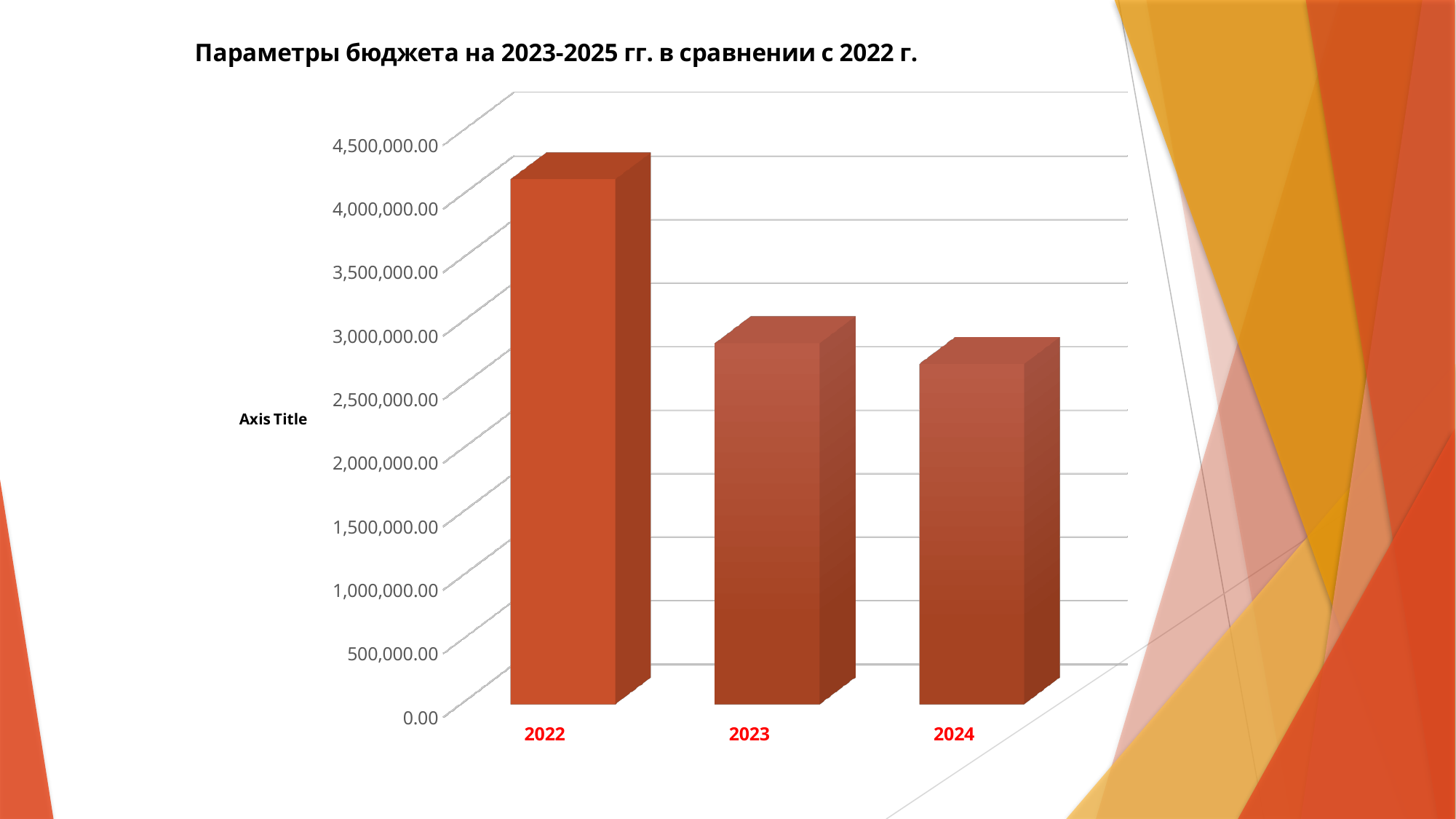
Is the value for 2023 greater or less than 3,500,000.00? less What text is shown as the vertical axis title? Axis Title What kind of chart is shown on the slide? bar chart Which is larger, the value for 2022 or the value for 2023? 2022 Is the value for 2024 greater or less than 3,000,000.00? less Which year has the highest bar? 2022 Which year has the lowest bar? 2024 Is the value for 2022 greater or less than 4,000,000.00? greater What is the title of the chart? Параметры бюджета на 2023-2025 гг. в сравнении с 2022 г. Do the values rise or fall from 2022 to 2024? fall How many categories are plotted on the x axis? 3